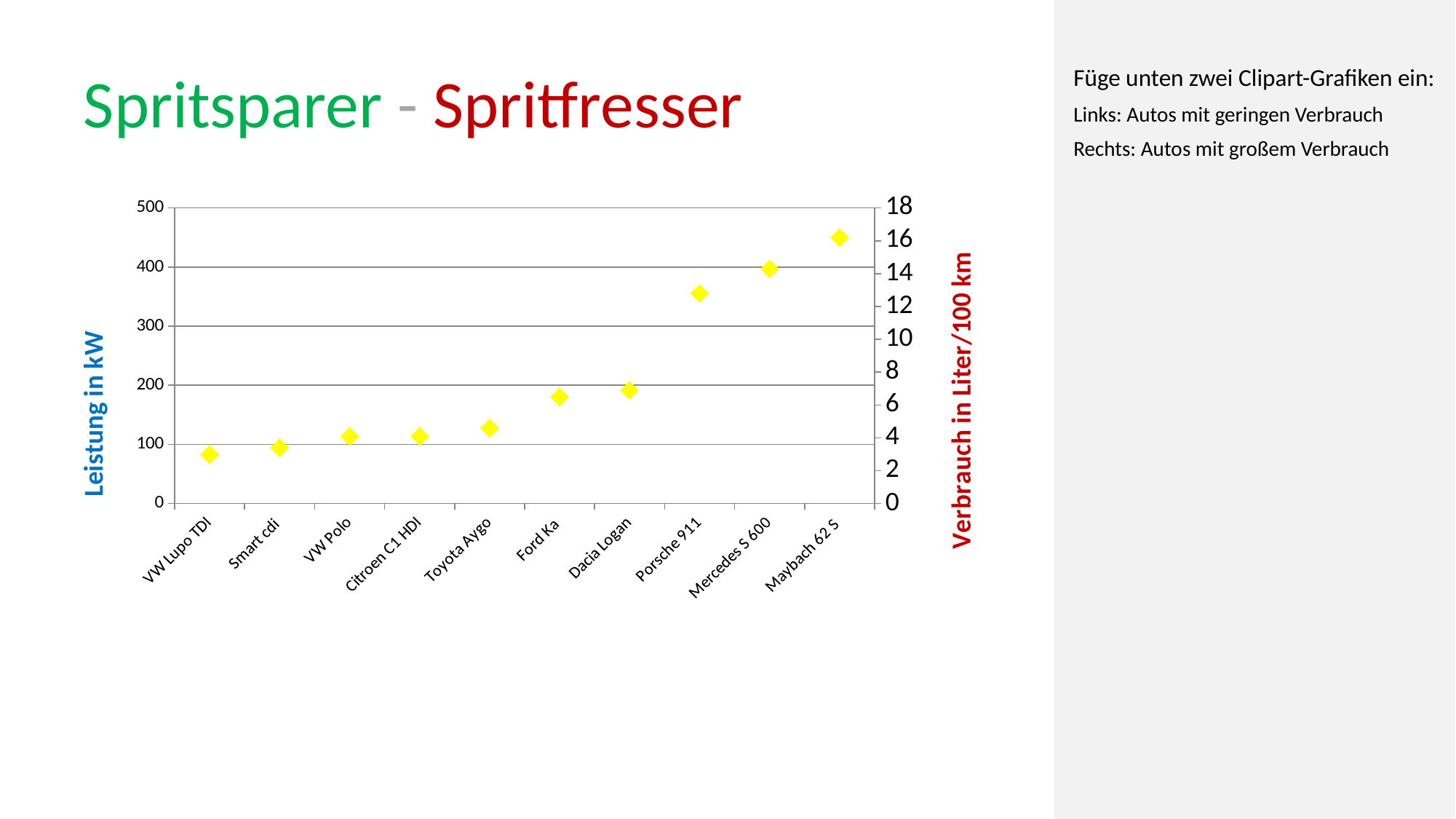
Which car has the highest plotted value in the chart? Maybach 62 S What is the title of the right vertical axis of the chart? Verbrauch in Liter/100 km What kind of chart is shown on the slide? Scatter chart Which has the larger plotted value, Mercedes S 600 or Porsche 911? Mercedes S 600 Do the plotted values rise or fall from VW Lupo TDI to Maybach 62 S along the x axis? Rise How many cars are plotted along the x axis of the chart? 10 What is the title of the left vertical axis of the chart? Leistung in kW Which has the larger plotted value, Porsche 911 or Ford Ka? Porsche 911 Which has the larger plotted value, Toyota Aygo or Smart cdi? Toyota Aygo Which car has the lowest plotted value in the chart? VW Lupo TDI